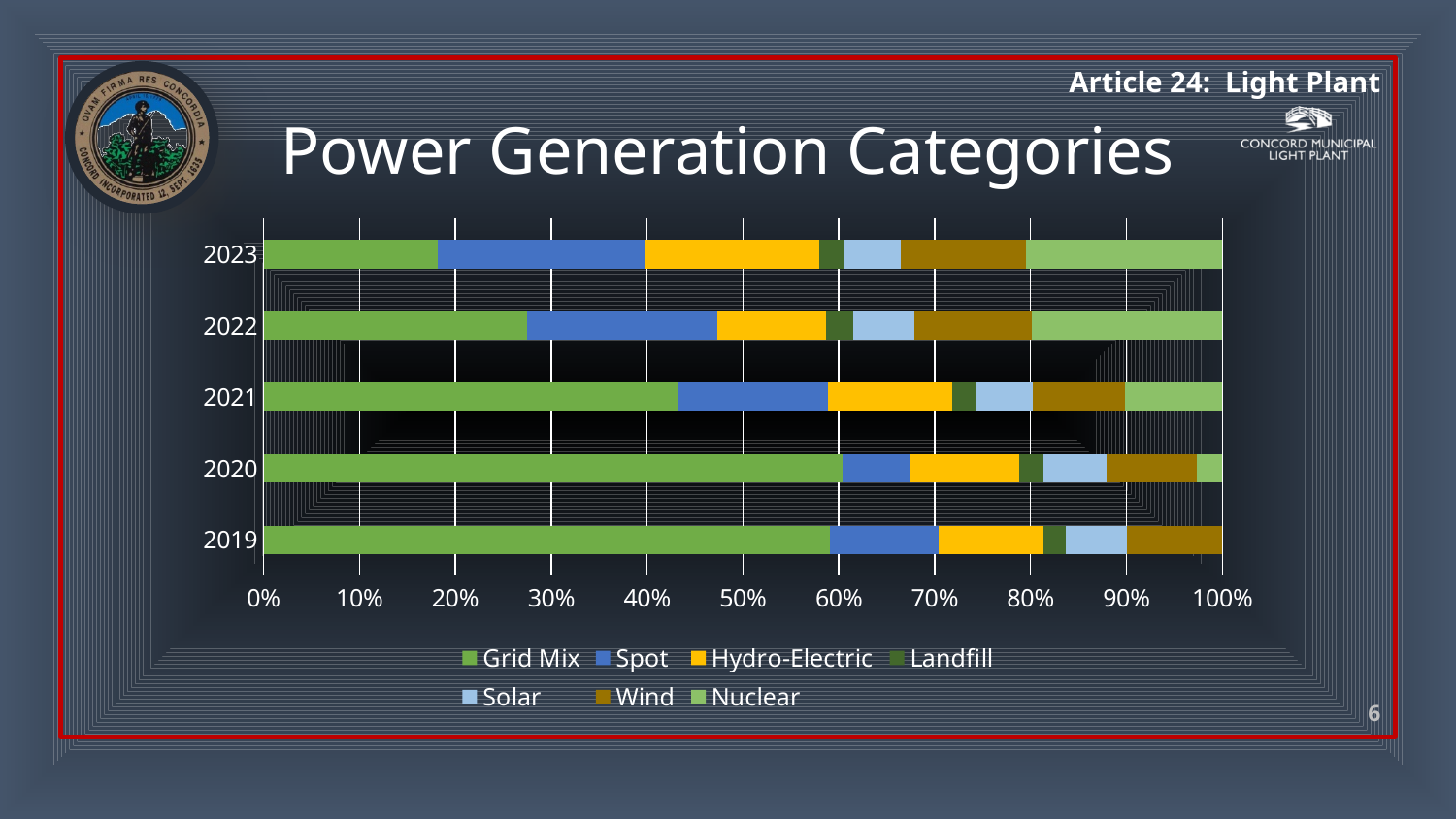
Which year has the largest Nuclear share among 2019, 2020 and 2021? 2021 Is the Grid Mix share for 2023 greater or less than 30%? less What is the title of the chart? Power Generation Categories Which year has the smallest Grid Mix share? 2023 Which year has the larger Grid Mix share, 2020 or 2021? 2020 Which year has the larger Grid Mix share, 2022 or 2023? 2022 How many series does the legend list? 7 Is the Grid Mix share for 2019 greater or less than 50%? greater Is the Grid Mix share for 2021 greater or less than 40%? greater How many years (categories) are plotted on the chart? 5 What kind of chart is shown on the slide? Stacked bar chart Does the Grid Mix share rise or fall from 2020 to 2023? fall